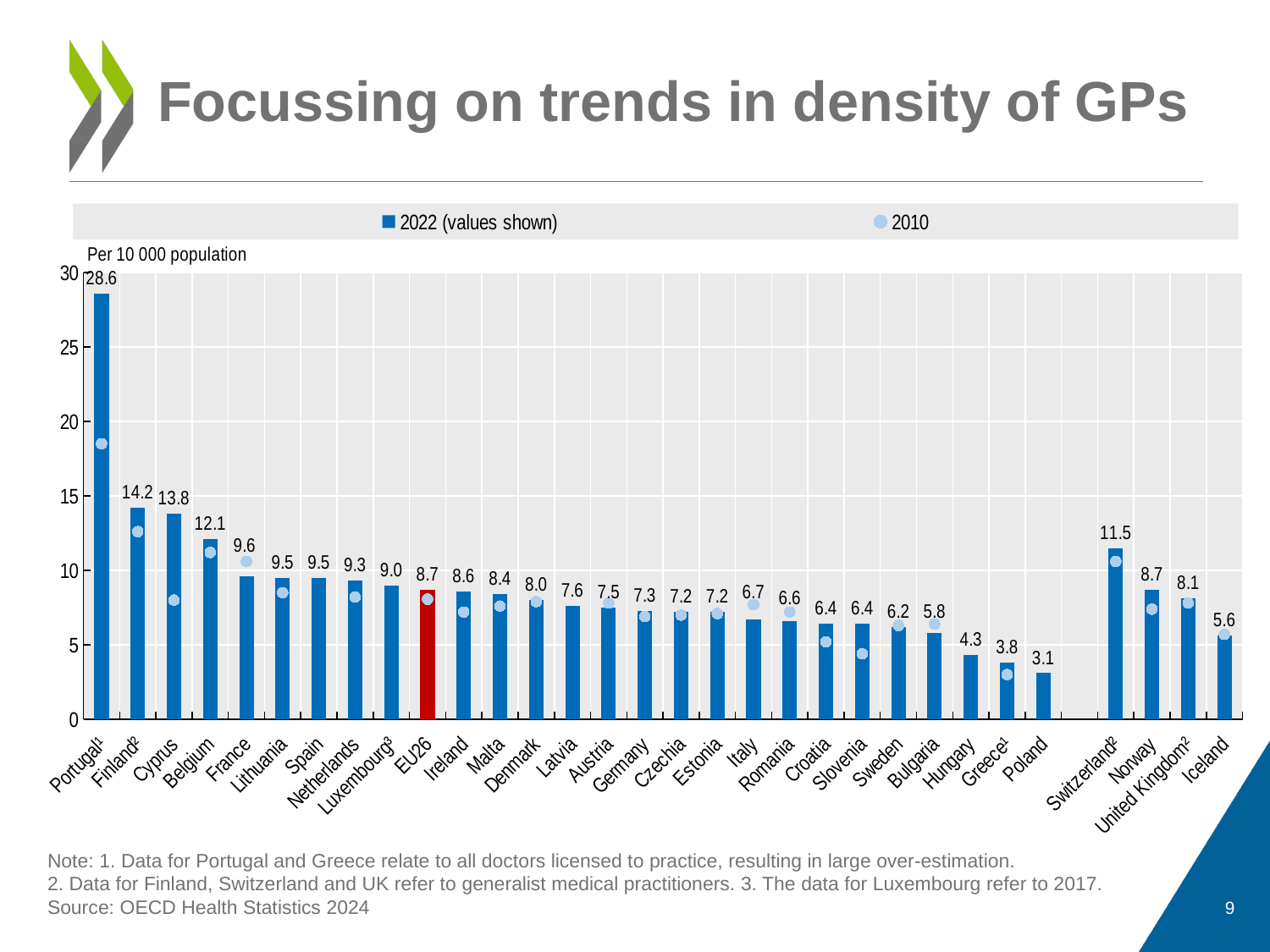
What is the 2022 value for EU26? 8.7 Which country has the highest 2022 value? Portugal What unit is stated above the y axis? Per 10 000 population What is the difference between the 2022 values for Belgium and France? 2.5 How many countries or groups are shown on the x axis? 31 How many series does the legend list? 2 Which country has the lowest 2022 value? Poland What kind of chart is shown on the slide? Bar chart Which has a larger 2022 value, Norway or Iceland? Norway Is the 2010 value for Portugal greater or less than 15? greater What is the 2022 value for Finland? 14.2 What is the 2022 value for Switzerland? 11.5